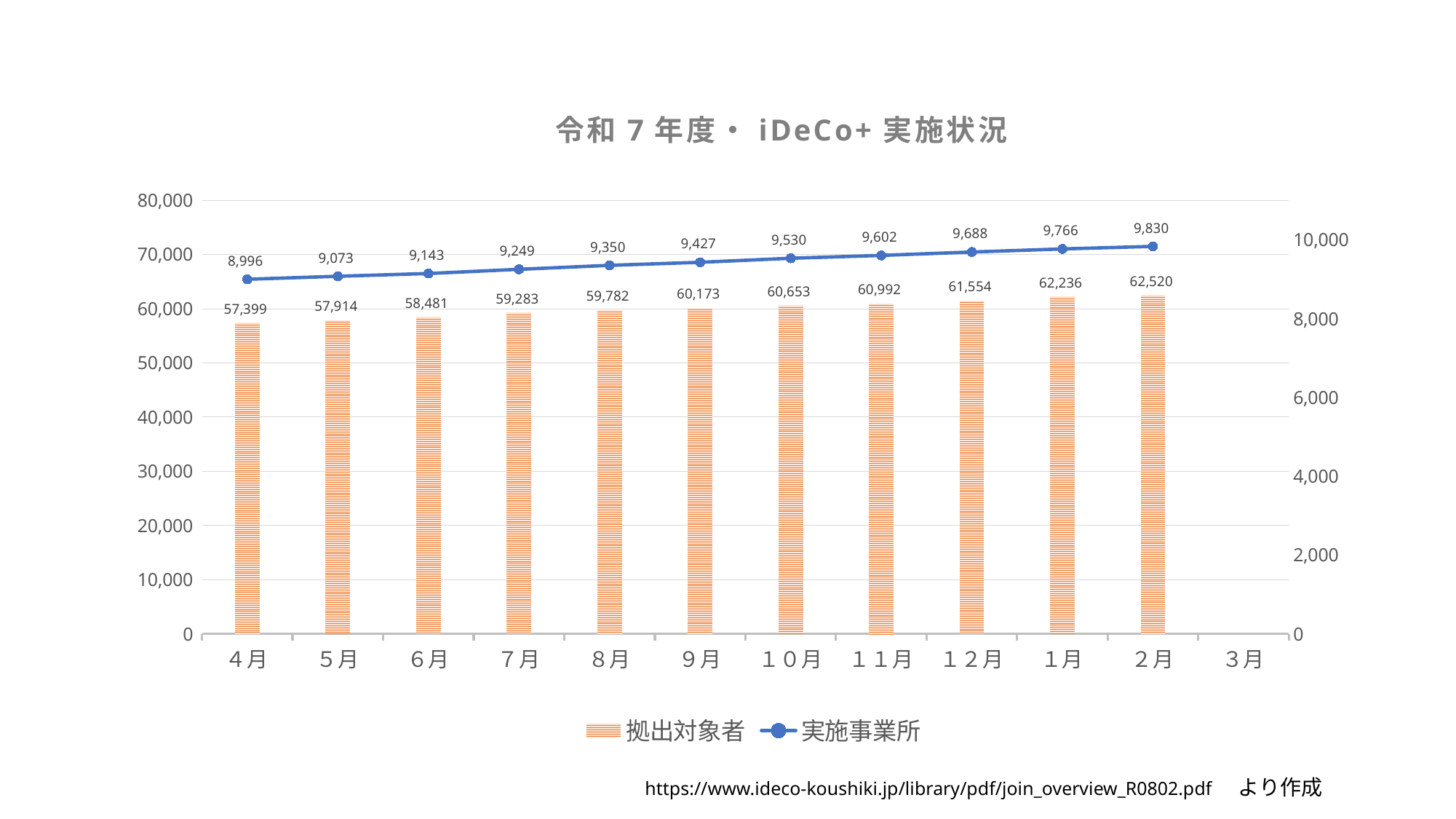
Which month has the lowest 実施事業所 value? 4月 How many months have data plotted in the chart? 11 What is the difference between the 実施事業所 values for 2月 and 4月? 834 Is the 拠出対象者 value for 4月 greater or less than 60,000? less What is the difference between the 拠出対象者 values for 2月 and 4月? 5,121 What is the 拠出対象者 value for 10月? 60,653 What is the 実施事業所 value for 2月? 9,830 Which month has the highest 拠出対象者 value? 2月 How many series does the legend list? 2 What is the 実施事業所 value for 8月? 9,350 What is the 拠出対象者 value for 4月? 57,399 Do the 実施事業所 values rise or fall from 4月 to 2月? rise